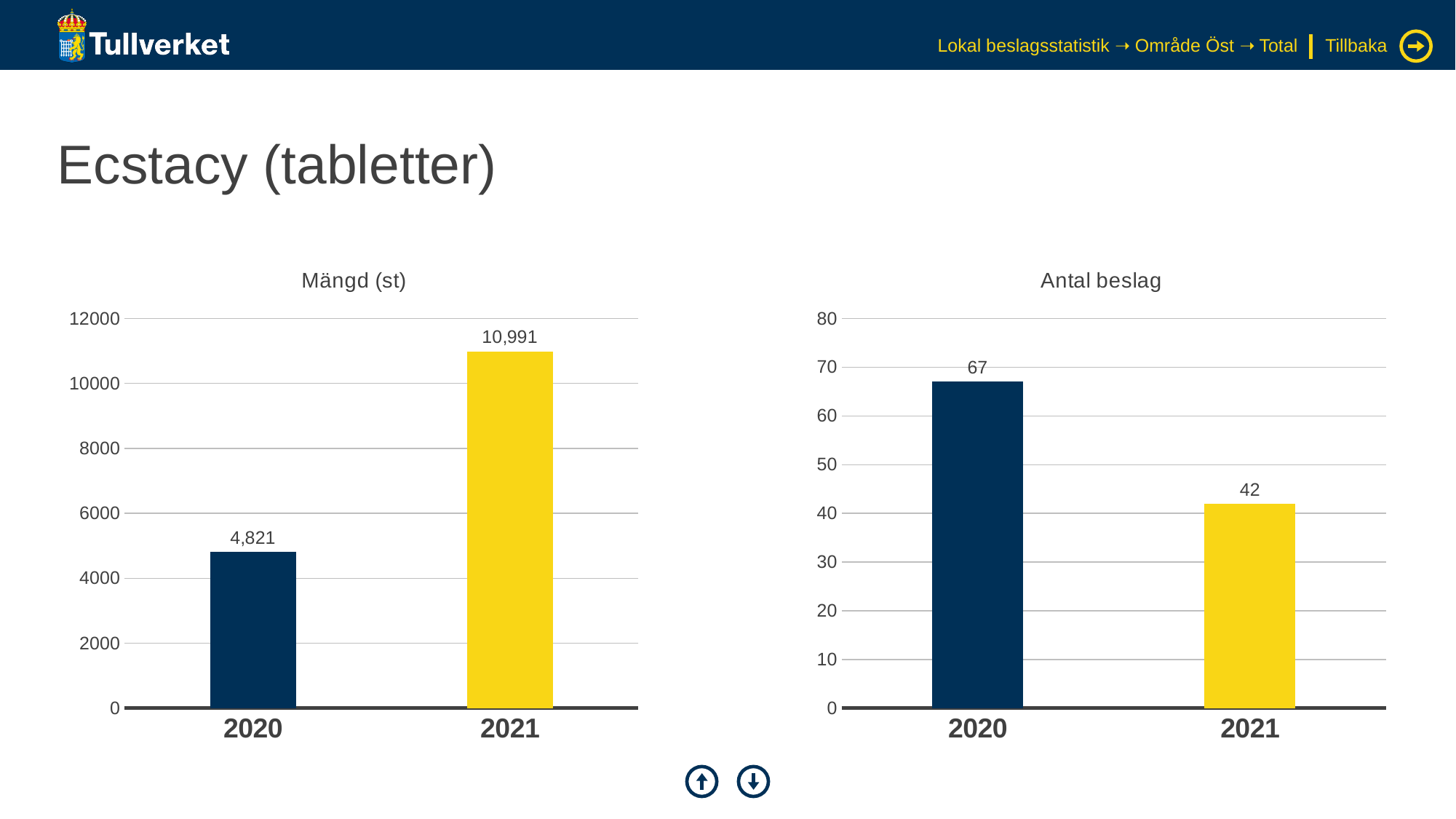
In the 'Mängd (st)' chart, what is the value for 2020? 4,821 In the 'Mängd (st)' chart, which year has the highest value? 2021 In the 'Antal beslag' chart, what is the value for 2020? 67 In the 'Antal beslag' chart, what is the difference between the 2020 and 2021 values? 25 In the 'Mängd (st)' chart, what is the difference between the 2021 and 2020 values? 6,170 In the 'Antal beslag' chart, is the value for 2020 greater or less than 60? greater In the 'Mängd (st)' chart, what is the value for 2021? 10,991 How many charts are shown on the slide? 2 In the 'Antal beslag' chart, what is the value for 2021? 42 What kind of chart is the 'Antal beslag' chart? bar chart In the 'Mängd (st)' chart, do the values rise or fall from 2020 to 2021? rise In the 'Antal beslag' chart, which year has the lowest value? 2021